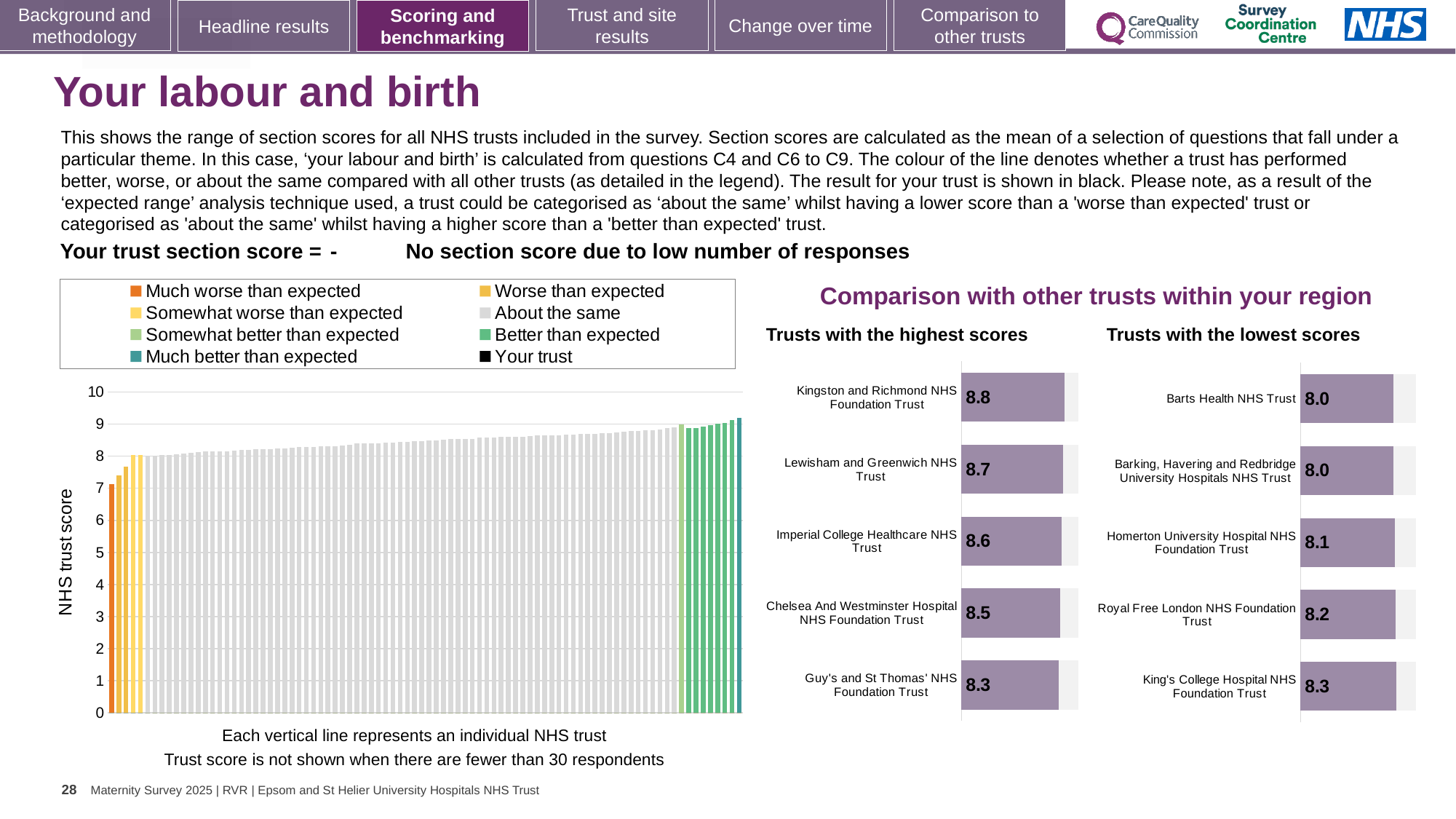
In the 'Trusts with the highest scores' chart, what is the score for Kingston and Richmond NHS Foundation Trust? 8.8 In the 'Trusts with the highest scores' chart, what is the score for Imperial College Healthcare NHS Trust? 8.6 In the large chart on the left, do the trust scores rise or fall from left to right? Rise In the 'Trusts with the lowest scores' chart, which has the higher score: Royal Free London NHS Foundation Trust or Homerton University Hospital NHS Foundation Trust? Royal Free London NHS Foundation Trust In the 'Trusts with the highest scores' chart, what is the difference between the scores of Kingston and Richmond NHS Foundation Trust and Guy's and St Thomas' NHS Foundation Trust? 0.5 How many entries does the legend above the large chart on the left list? 8 In the 'Trusts with the lowest scores' chart, what is the score for King's College Hospital NHS Foundation Trust? 8.3 How many trusts are listed in the 'Trusts with the lowest scores' chart? 5 In the 'Trusts with the highest scores' chart, which trust has the highest score? Kingston and Richmond NHS Foundation Trust In the 'Trusts with the lowest scores' chart, what is the score for Homerton University Hospital NHS Foundation Trust? 8.1 In the large chart on the left, is the value of the rightmost bar greater or less than 9? greater What kind of chart is the large chart on the left showing NHS trust scores? Bar chart